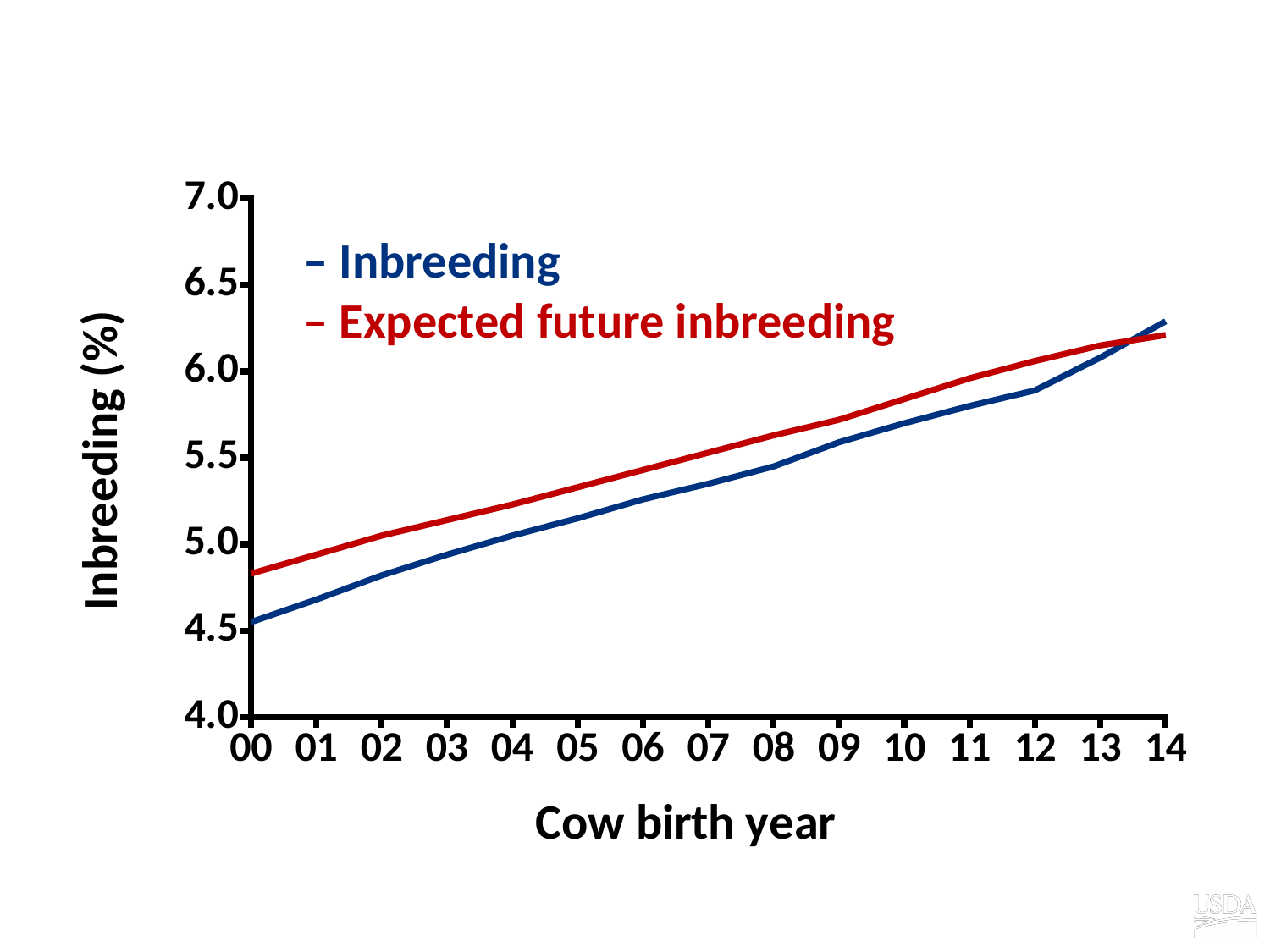
Does the Inbreeding line rise or fall from birth year 00 to 14? rise What is the title of the x axis? Cow birth year Does the Expected future inbreeding line rise or fall across the birth years? rise Is the Expected future inbreeding value for birth year 04 greater or less than 5.0? greater At birth year 00, which series has the higher value, Inbreeding or Expected future inbreeding? Expected future inbreeding Is the Expected future inbreeding value for birth year 14 greater or less than 6.0? greater Is the Inbreeding value for birth year 12 greater or less than 6.0? less How many series does the legend list? 2 How many cow birth years are shown along the x axis? 15 At birth year 06, which series has the higher value, Inbreeding or Expected future inbreeding? Expected future inbreeding What kind of chart is shown on the slide? line chart